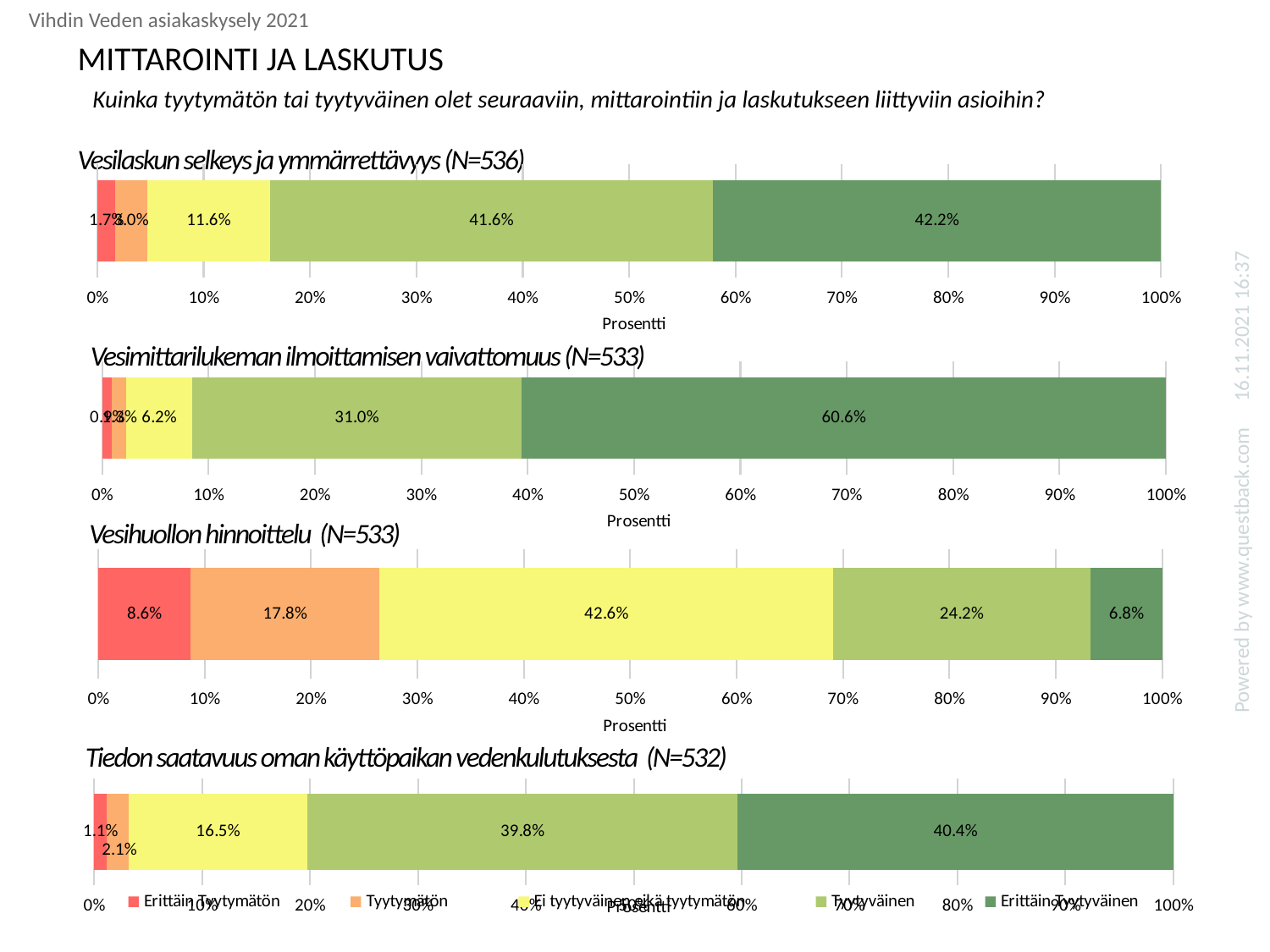
What kind of chart is used on this slide? Stacked bar chart In the chart 'Vesihuollon hinnoittelu (N=533)', which category has the largest share? Ei tyytyväinen eikä tyytymätön In the chart 'Vesilaskun selkeys ja ymmärrettävyys (N=536)', what is the value for 'Ei tyytyväinen eikä tyytymätön'? 11.6% In the chart 'Vesimittarilukeman ilmoittamisen vaivattomuus (N=533)', which category has the largest share? Erittäin tyytyväinen In the chart 'Vesimittarilukeman ilmoittamisen vaivattomuus (N=533)', what is the value for 'Erittäin tyytyväinen'? 60.6% In the chart 'Tiedon saatavuus oman käyttöpaikan vedenkulutuksesta (N=532)', is the value for 'Erittäin tyytyväinen' greater or less than 30%? greater In the chart 'Tiedon saatavuus oman käyttöpaikan vedenkulutuksesta (N=532)', what is the value for 'Tyytyväinen'? 39.8% In the chart 'Vesihuollon hinnoittelu (N=533)', what is the value for 'Ei tyytyväinen eikä tyytymätön'? 42.6% In the chart 'Vesilaskun selkeys ja ymmärrettävyys (N=536)', which is larger: 'Tyytyväinen' or 'Ei tyytyväinen eikä tyytymätön'? Tyytyväinen In the chart 'Vesihuollon hinnoittelu (N=533)', what is the value for 'Erittäin tyytymätön'? 8.6% How many series does the legend list? 5 In the chart 'Vesihuollon hinnoittelu (N=533)', what is the difference between 'Tyytyväinen' and 'Erittäin tyytyväinen'? 17.4%